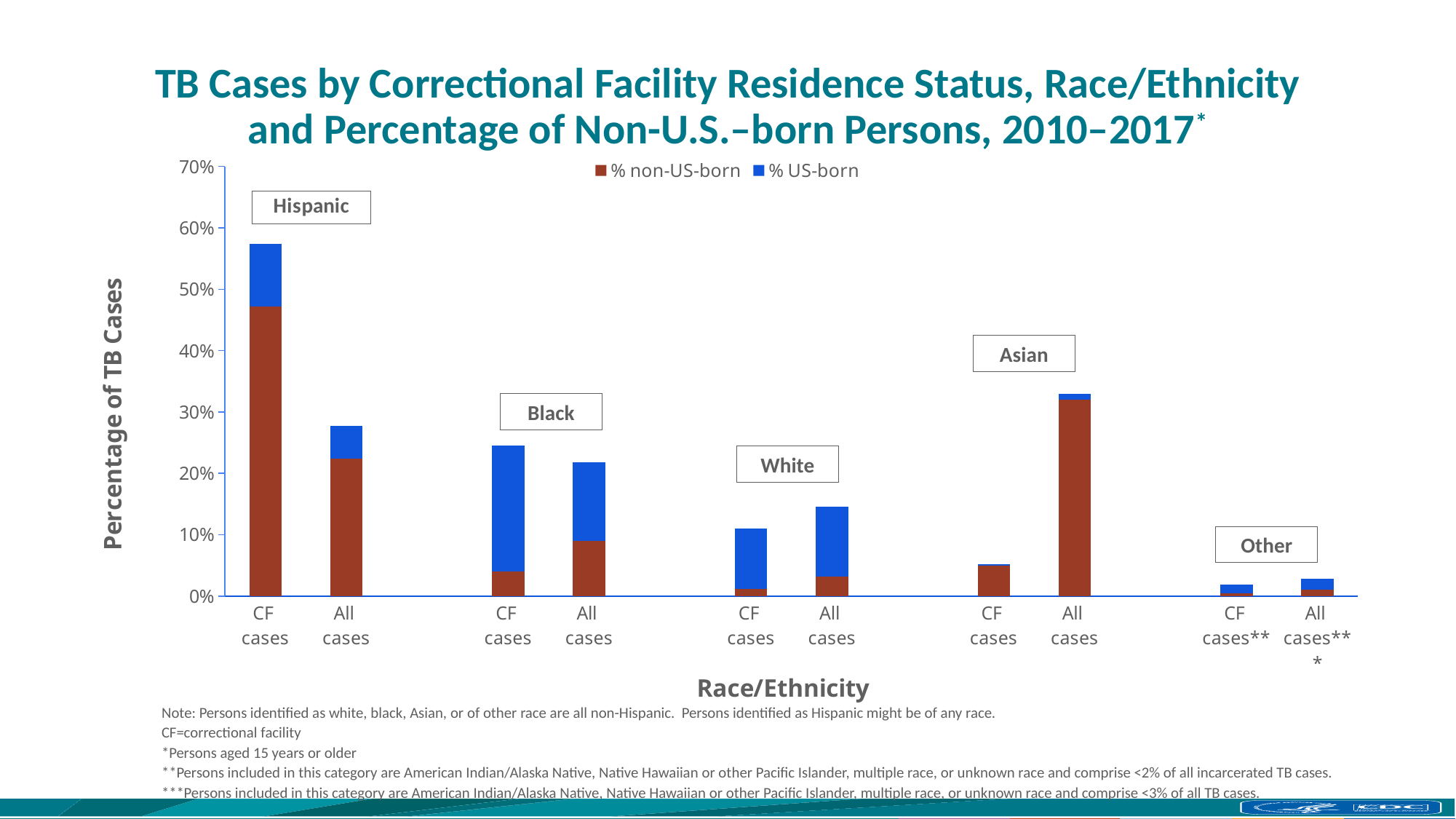
For the Hispanic group, which bar is taller: CF cases or All cases? CF cases Is the total value for Asian All cases greater or less than 30%? greater Which bar is the shortest in the chart? Other CF cases Which bar is the tallest in the chart? Hispanic CF cases How many series does the legend list? 2 For the Asian group, which bar is taller: CF cases or All cases? All cases Is the total value for Hispanic All cases greater or less than 30%? less What kind of chart is shown on the slide? Stacked bar chart What are the two series named in the legend? % non-US-born and % US-born Is the total value for Hispanic CF cases greater or less than 50%? greater How many bars are plotted in the chart? 10